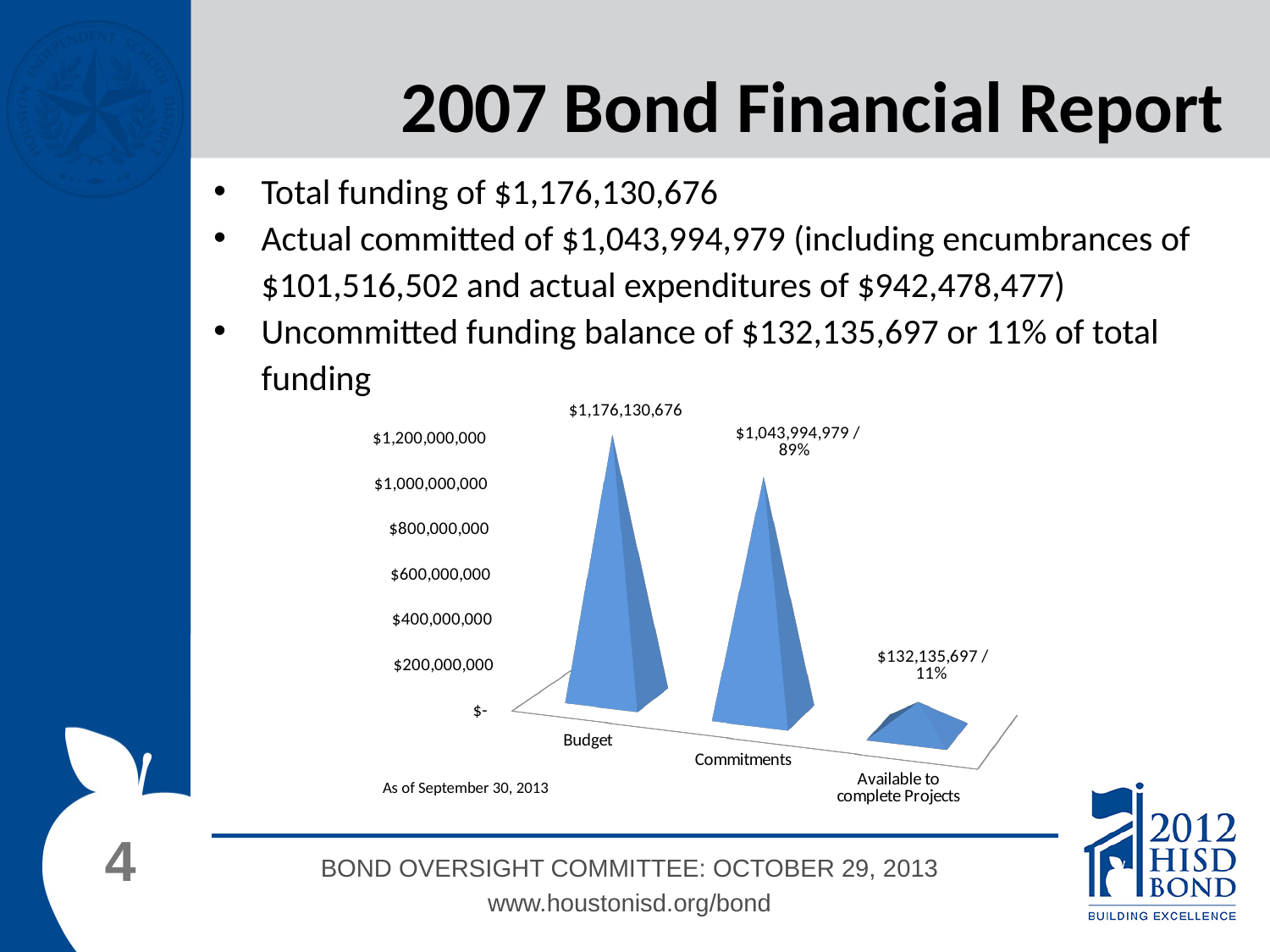
What percentage is shown next to the Commitments value in the chart? 89% Which category has the lowest value in the chart? Available to complete Projects What date note appears below the chart? As of September 30, 2013 Is the value for Commitments greater or less than $1,000,000,000? greater What is the value shown for Commitments in the chart? $1,043,994,979 How many categories are plotted in the chart? 3 Which is larger in the chart, Commitments or Available to complete Projects? Commitments What is the value shown for Budget in the chart? $1,176,130,676 Which category has the highest value in the chart? Budget What percentage is shown next to the Available to complete Projects value in the chart? 11% What is the difference between the Budget value and the Commitments value in the chart? $132,135,697 What is the value shown for Available to complete Projects in the chart? $132,135,697